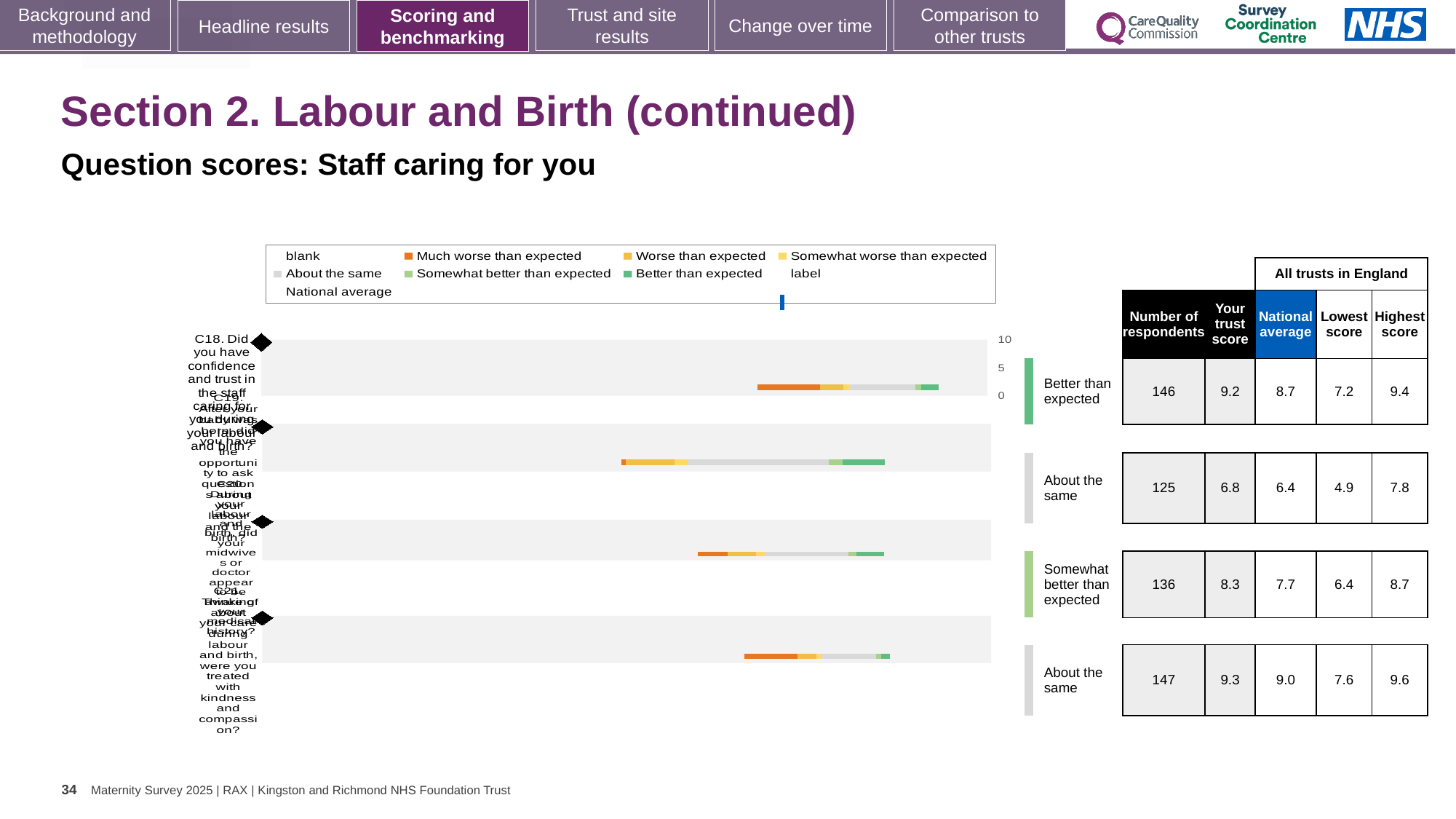
In the chart legend, what colour represents 'Much worse than expected'? orange What is the highest value shown on the chart's score axis? 10 In the table beside the chart, how many respondents answered the fourth question (C21)? 147 For the third question (C20), which is larger: the trust score or the national average? trust score What kind of chart is shown on the slide? bar chart How many questions (bars) are plotted in the chart? 4 In the table beside the chart, what is the trust score for the first question (C18)? 9.2 In the table beside the chart, what is the national average for the second question (C19)? 6.4 In the chart legend, what colour represents 'Better than expected'? green Which question has the highest trust score in the table beside the chart? C21 Which question has the lowest trust score in the table beside the chart? C19 For the first question (C18), what is the difference between the trust score and the national average? 0.5